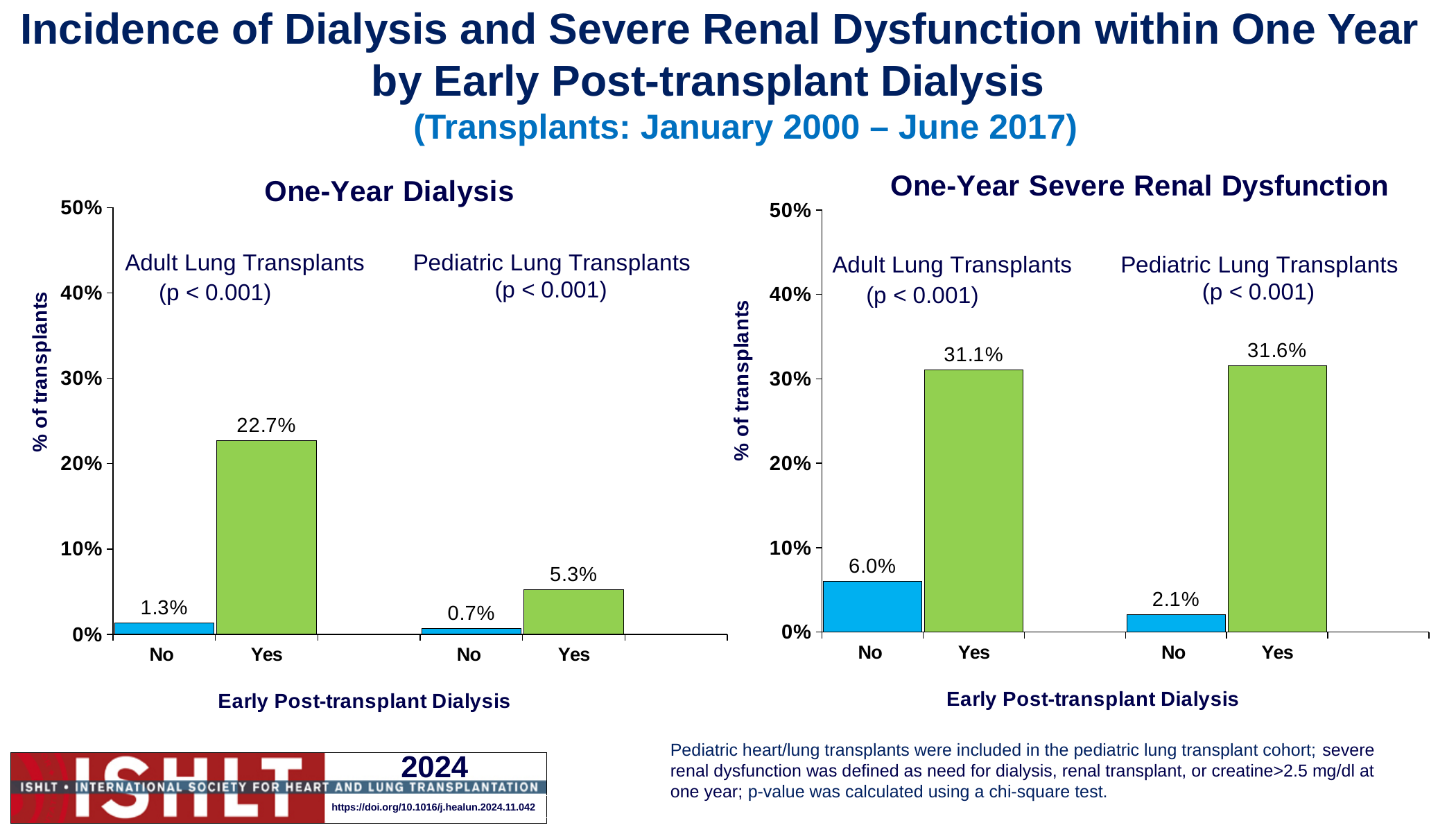
In the One-Year Severe Renal Dysfunction chart, is the value for adult lung transplants with early dialysis (Yes) greater or less than 30%? greater In the One-Year Dialysis chart, what is the value for pediatric lung transplants without early post-transplant dialysis (No)? 0.7% In the One-Year Dialysis chart, what is the value for adult lung transplants with early post-transplant dialysis (Yes)? 22.7% In the One-Year Dialysis chart, which bar is the highest? Adult Lung Transplants, Yes In the One-Year Severe Renal Dysfunction chart, which bar is the lowest? Pediatric Lung Transplants, No What type of chart is the One-Year Severe Renal Dysfunction chart? Bar chart In the One-Year Severe Renal Dysfunction chart, what is the value for adult lung transplants without early post-transplant dialysis (No)? 6.0% In the One-Year Dialysis chart, which is larger: the Yes value for adult lung transplants or the Yes value for pediatric lung transplants? Adult Lung Transplants How many bars are plotted in the One-Year Dialysis chart? 4 In the One-Year Severe Renal Dysfunction chart, what is the value for pediatric lung transplants with early post-transplant dialysis (Yes)? 31.6% In the One-Year Dialysis chart, what is the difference between the Yes and No values for adult lung transplants? 21.4% In the One-Year Severe Renal Dysfunction chart, what is the difference between the Yes and No values for pediatric lung transplants? 29.5%